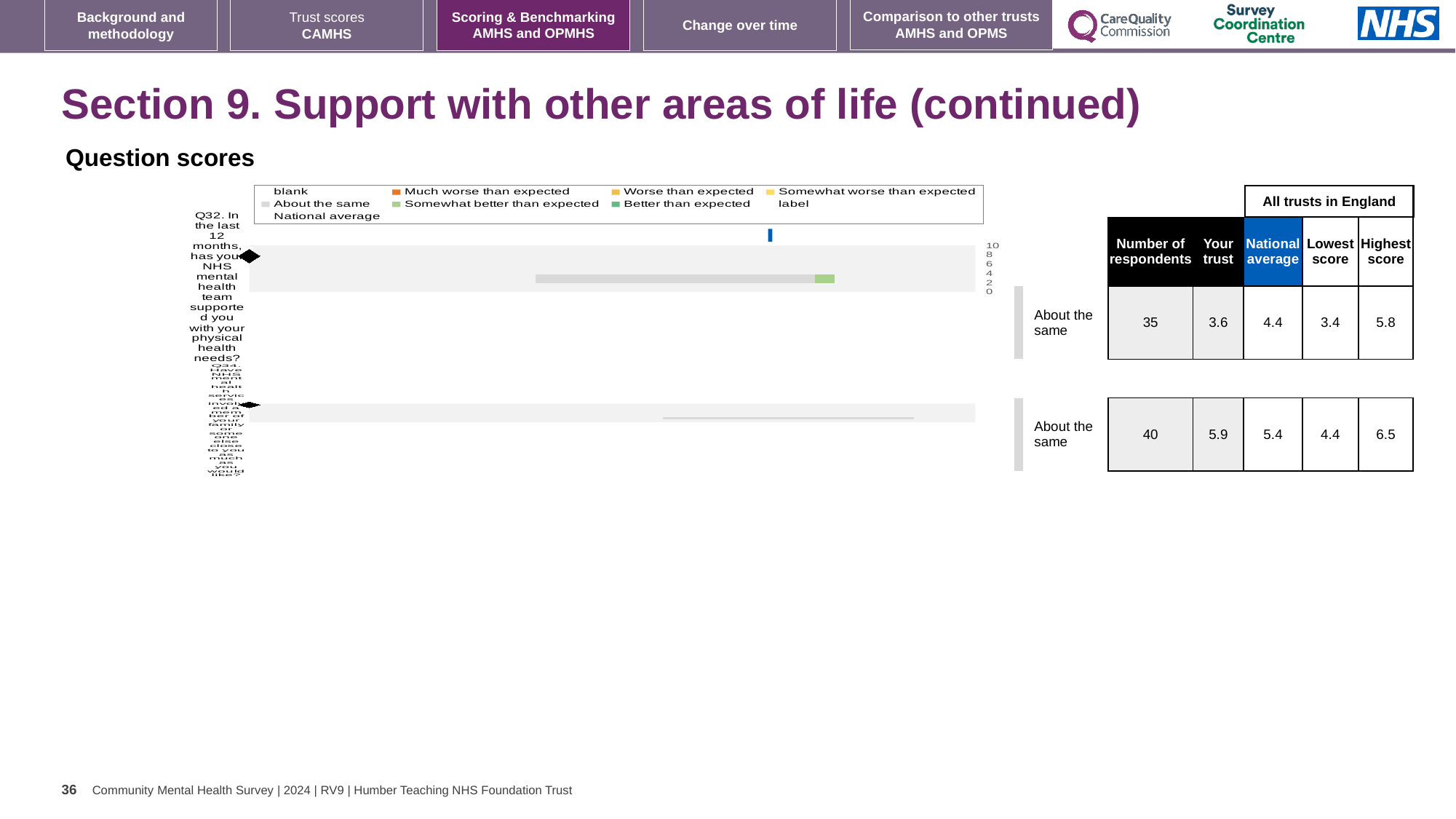
What kind of chart is shown under 'Question scores'? bar chart What is the difference between the highest score and the lowest score for Q32 in the table beside the chart? 2.4 What is the highest value shown on the chart's numeric axis? 10 What is the highest score across all trusts in England for Q34 in the table beside the chart? 6.5 What colour is used for 'Much worse than expected' in the chart legend? orange According to the table beside the chart, what is the 'Your trust' score for Q32? 3.6 For Q32, which is larger in the table beside the chart: the 'Your trust' score or the national average? National average How many questions (categories) are plotted in the chart? 2 What is the difference between the 'Your trust' score and the national average for Q34 in the table beside the chart? 0.5 For Q34, which is larger in the table beside the chart: the 'Your trust' score or the national average? Your trust How many respondents are listed for Q34 in the table beside the chart? 40 According to the table beside the chart, what is the national average for Q34? 5.4